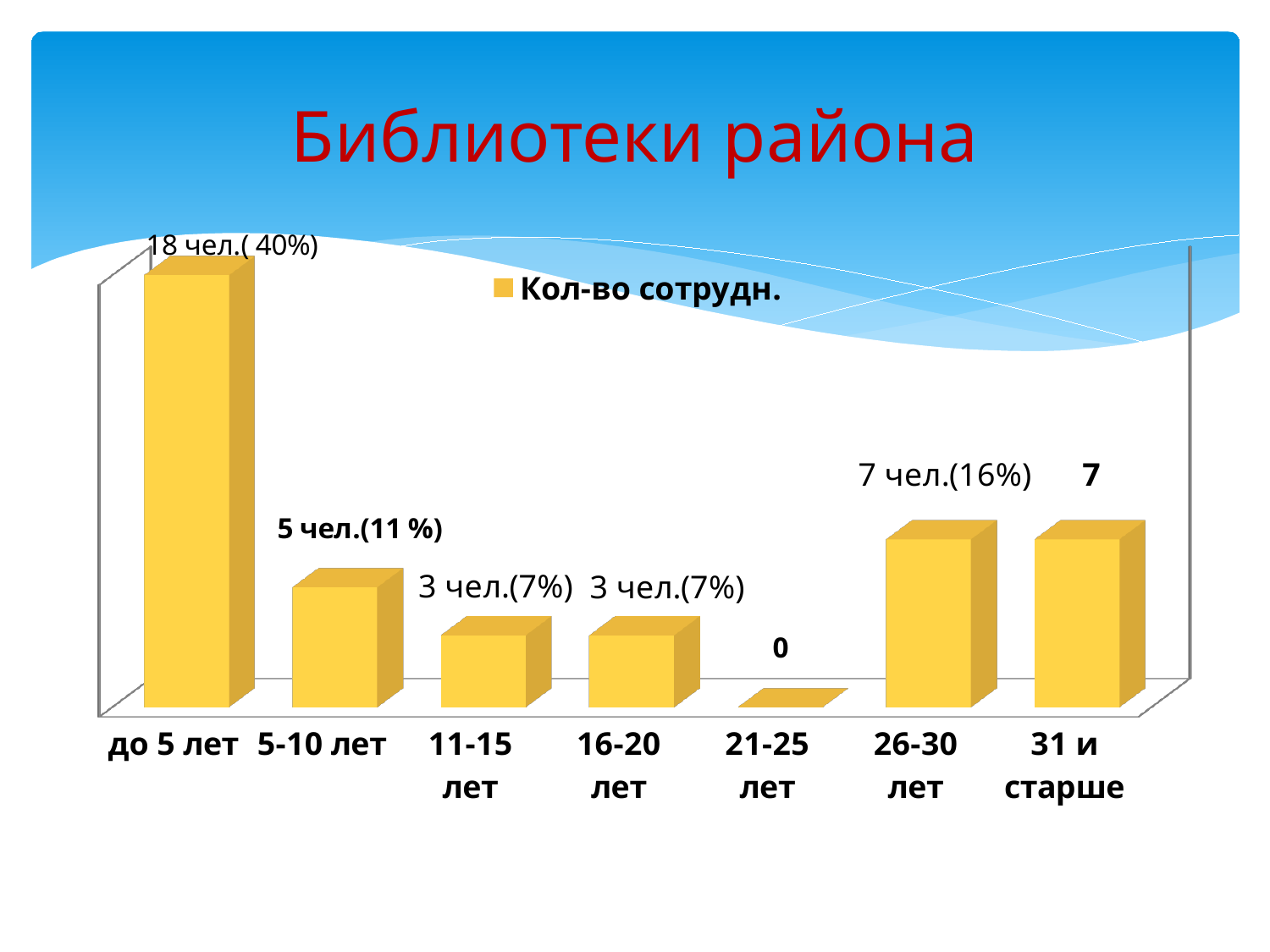
What value is shown for the '31 и старше' category? 7 What is the data label on the bar for 'до 5 лет'? 18 чел.( 40%) What value is shown for the '21-25 лет' category? 0 How many more employees are in the 'до 5 лет' category than in the '5-10 лет' category? 13 What is the data label on the bar for '5-10 лет'? 5 чел.(11 %) What type of chart is shown on the slide? bar chart Which category has the lowest number of employees? 21-25 лет Which category has the highest number of employees? до 5 лет What is the legend entry of the chart? Кол-во сотрудн. How many categories are shown on the x axis of the chart? 7 Which category has more employees, '5-10 лет' or '26-30 лет'? 26-30 лет What is the data label on the bar for '26-30 лет'? 7 чел.(16%)